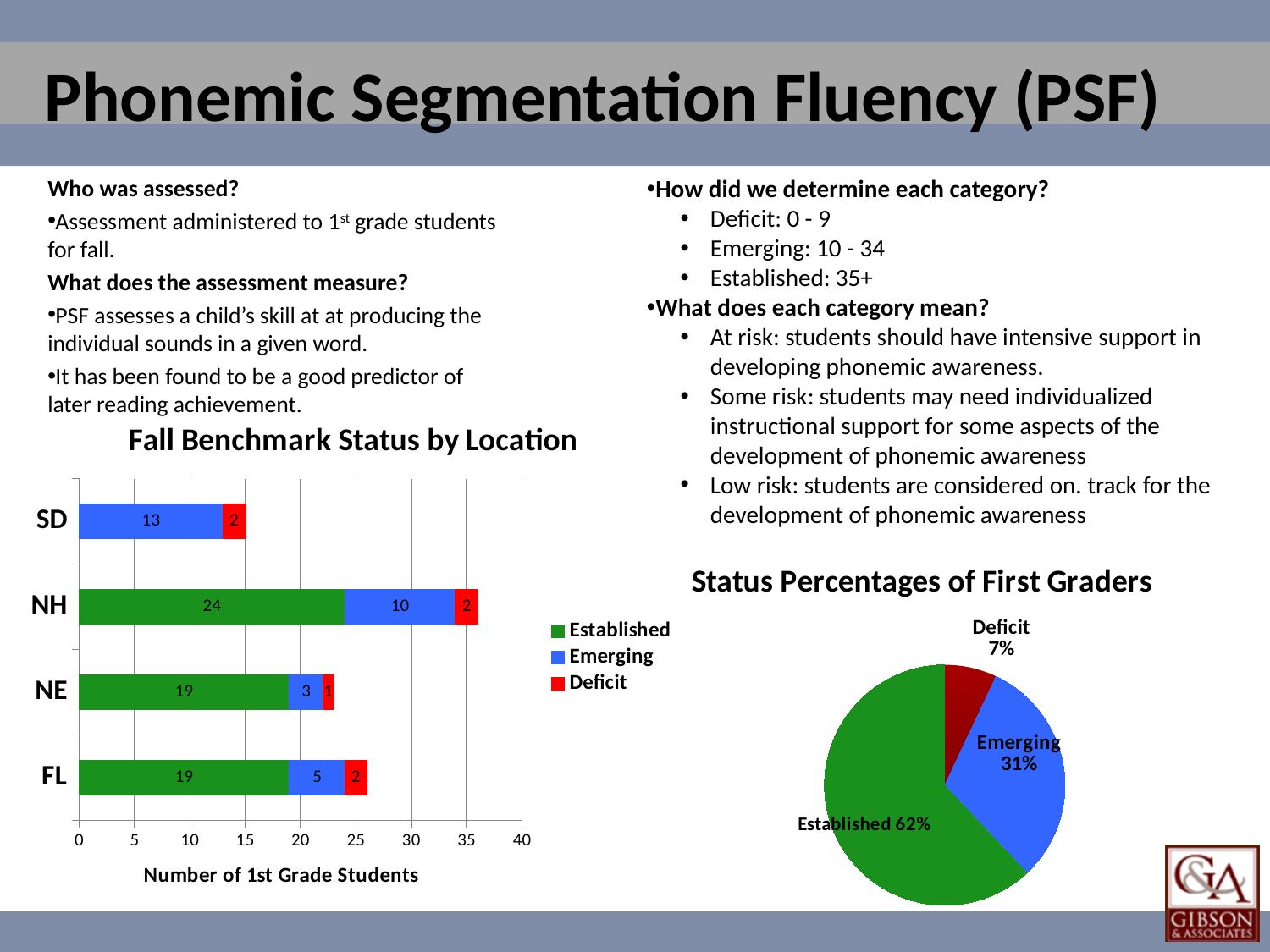
In the 'Fall Benchmark Status by Location' chart, what is the difference between the Emerging values for NH and FL? 5 In the 'Status Percentages of First Graders' pie chart, what share is Emerging? 31% In the 'Fall Benchmark Status by Location' chart, how many students at NH are Established? 24 In the 'Status Percentages of First Graders' pie chart, which category has the smallest share? Deficit In the 'Fall Benchmark Status by Location' chart, how many students at NE are Deficit? 1 In the 'Fall Benchmark Status by Location' chart, what is the total number of students for NH? 36 In the 'Fall Benchmark Status by Location' chart, how many series does the legend list? 3 What kind of chart is 'Fall Benchmark Status by Location'? Stacked bar chart In the 'Fall Benchmark Status by Location' chart, how many locations are shown? 4 In the 'Fall Benchmark Status by Location' chart, which location has the largest Established value? NH In the 'Fall Benchmark Status by Location' chart, how many students at SD are Emerging? 13 In the 'Fall Benchmark Status by Location' chart, what is the total number of students for FL? 26